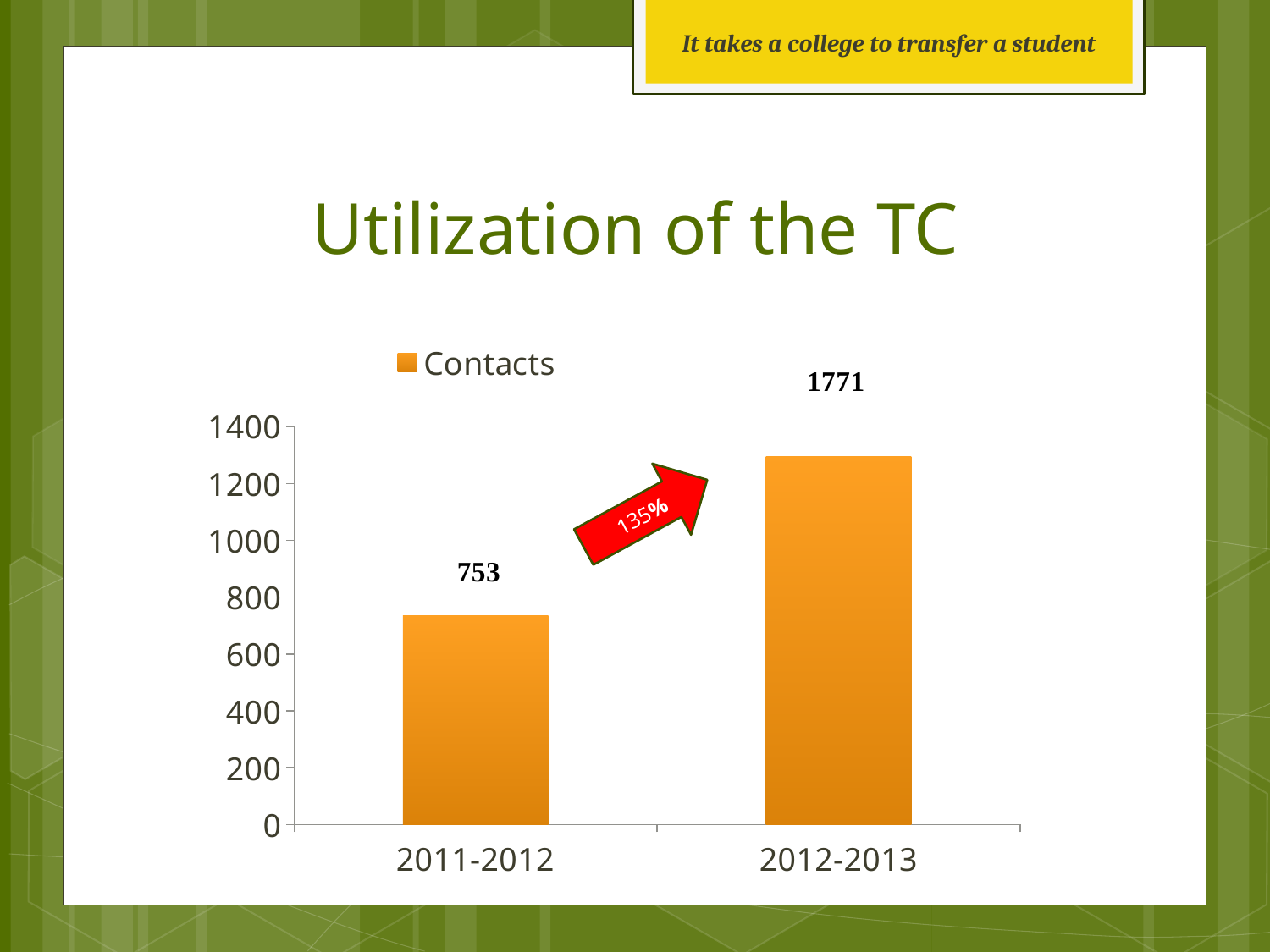
Is the value for 2011-2012 greater or less than 800? less What percentage is written on the red arrow between the two bars? 135% What kind of chart is shown on the slide? bar chart What is the value for 2012-2013? 1771 Is the value for 2012-2013 greater or less than 1000? greater What is the value for 2011-2012? 753 What is the difference between the values for 2012-2013 and 2011-2012? 1018 How many series does the legend list? 1 How many categories are shown on the x axis? 2 Which category has the lowest value? 2011-2012 Which category has the highest value? 2012-2013 Which is larger, the value for 2011-2012 or the value for 2012-2013? 2012-2013